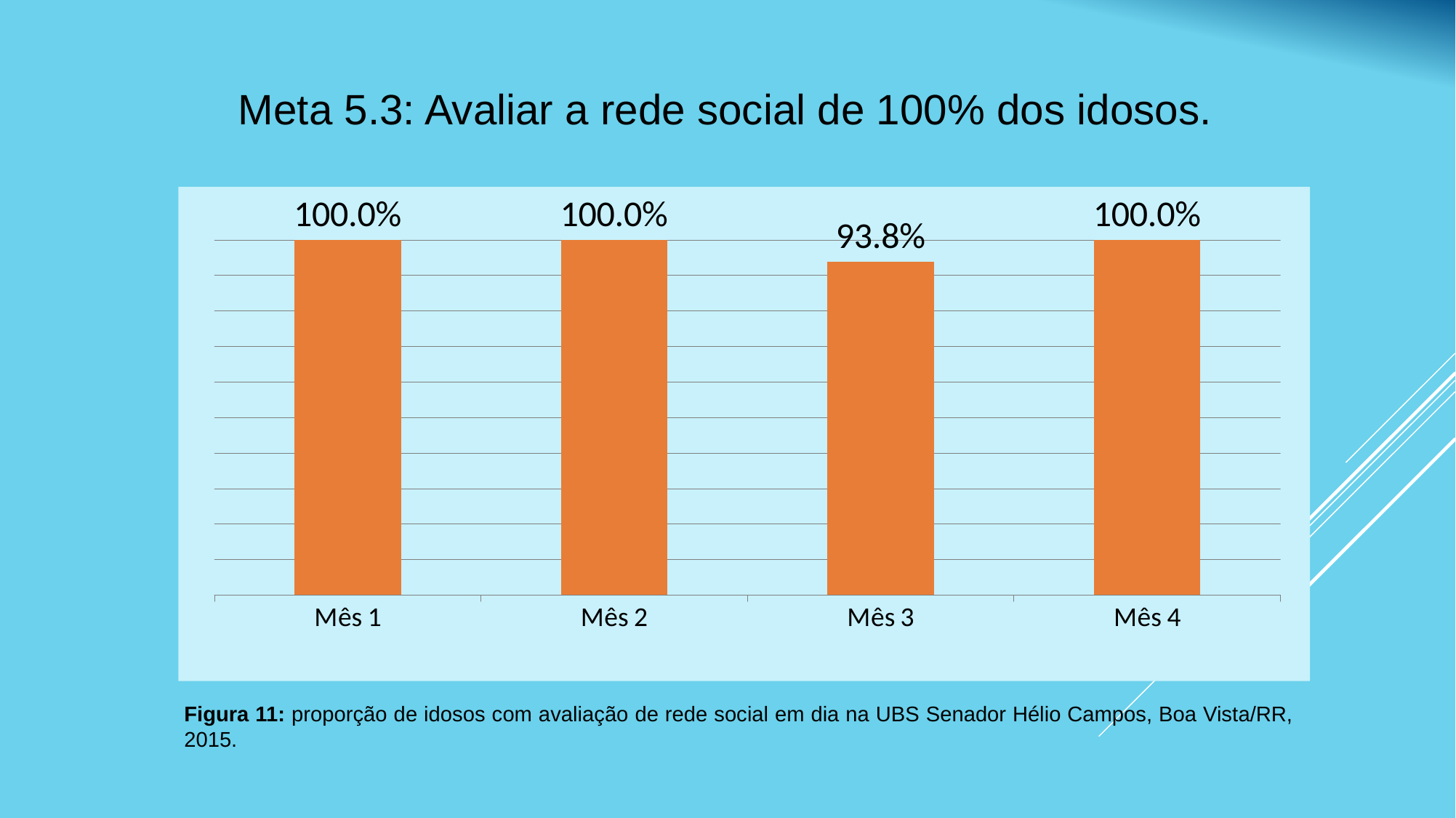
What is the difference between the values for Mês 2 and Mês 3? 6.2% What is the value for Mês 4? 100.0% Do the values rise or fall from Mês 2 to Mês 3? Fall How many months reach 100.0%? 3 What is the value for Mês 1? 100.0% How many months are shown on the x axis? 4 What is the value for Mês 3? 93.8% Which is larger, the value for Mês 3 or the value for Mês 4? Mês 4 What colour are the bars in the chart? Orange What is the figure number given in the caption below the chart? Figura 11 Which month has the lowest value? Mês 3 What kind of chart is shown on the slide? Bar chart